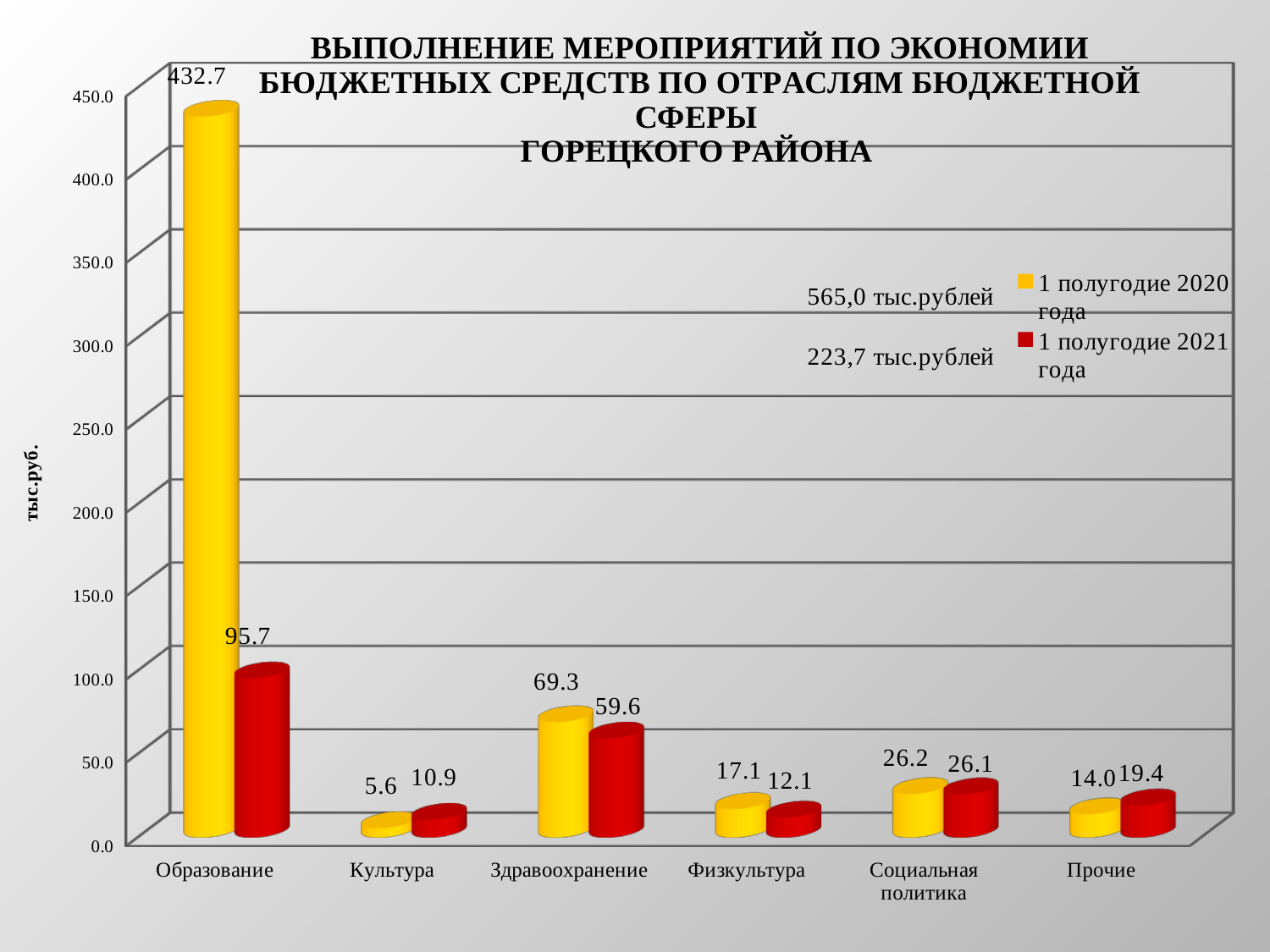
What kind of chart is shown on the slide? Bar chart Which category has the highest value in the series 1 полугодие 2021 года? Образование What is the difference between the 1 полугодие 2020 года and 1 полугодие 2021 года values for Образование? 337.0 How many categories are shown on the x axis? 6 Is the value for Образование in the series 1 полугодие 2020 года greater or less than 400.0? greater What is the value for Культура in the series 1 полугодие 2020 года? 5.6 What is the value for Здравоохранение in the series 1 полугодие 2021 года? 59.6 What is the value for Образование in the series 1 полугодие 2020 года? 432.7 How many series does the legend list? 2 Which category has the lowest value in the series 1 полугодие 2020 года? Культура What is the label of the vertical axis? тыс.руб. Which is larger for Прочие: the value for 1 полугодие 2020 года or 1 полугодие 2021 года? 1 полугодие 2021 года